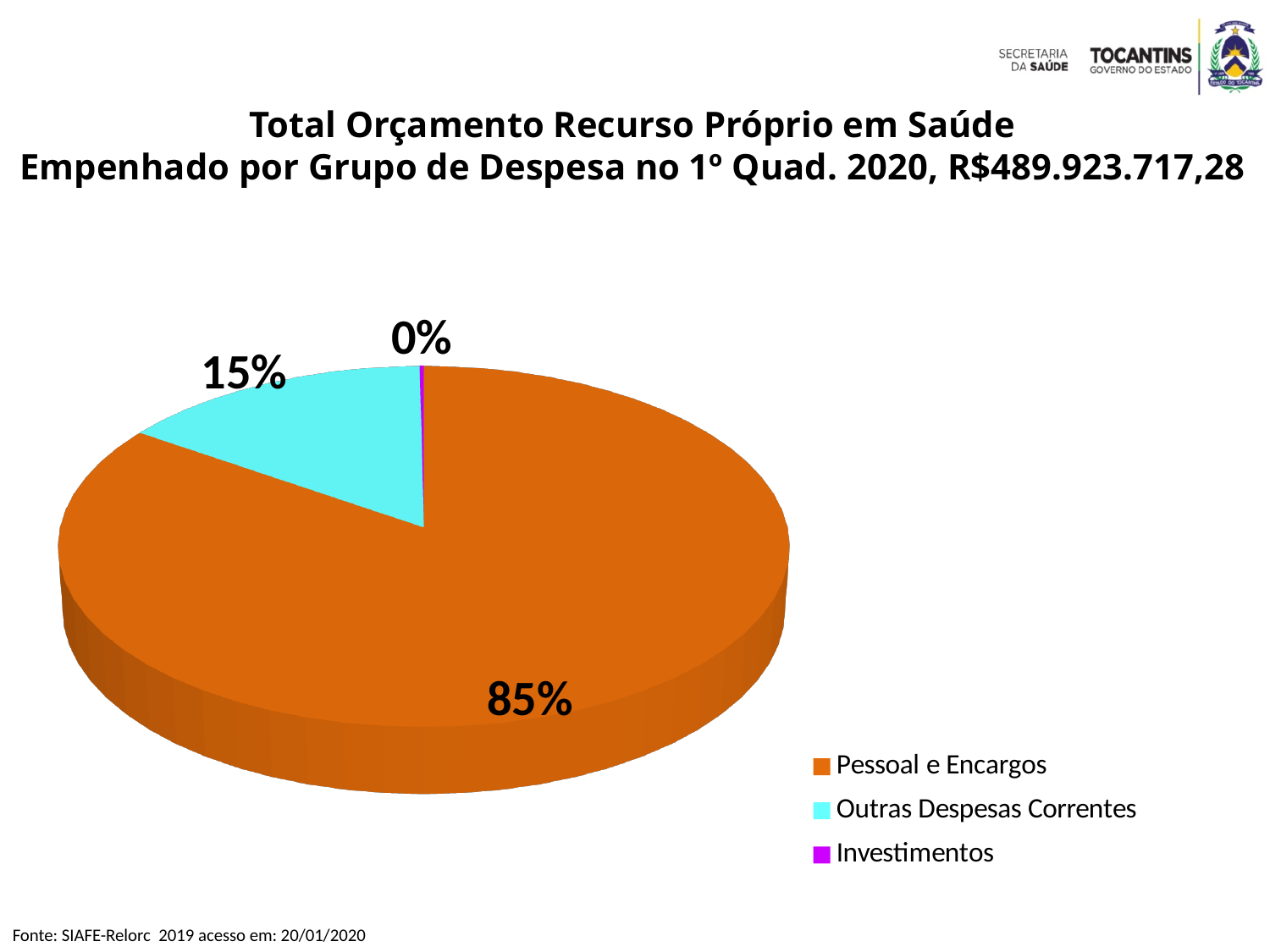
How many expense groups are shown in the pie chart? 3 What is the difference in percentage points between Pessoal e Encargos and Outras Despesas Correntes? 70 percentage points Which expense group has the smallest slice of the pie? Investimentos What total amount is stated in the chart title? R$489.923.717,28 What colour is the slice for Outras Despesas Correntes? Cyan What kind of chart is shown on the slide? Pie chart What share of the pie does Pessoal e Encargos represent? 85% Which is larger, the share for Outras Despesas Correntes or the share for Investimentos? Outras Despesas Correntes Which expense group has the largest slice of the pie? Pessoal e Encargos What share of the pie does Investimentos represent? 0% What share of the pie does Outras Despesas Correntes represent? 15% How many entries does the legend list? 3